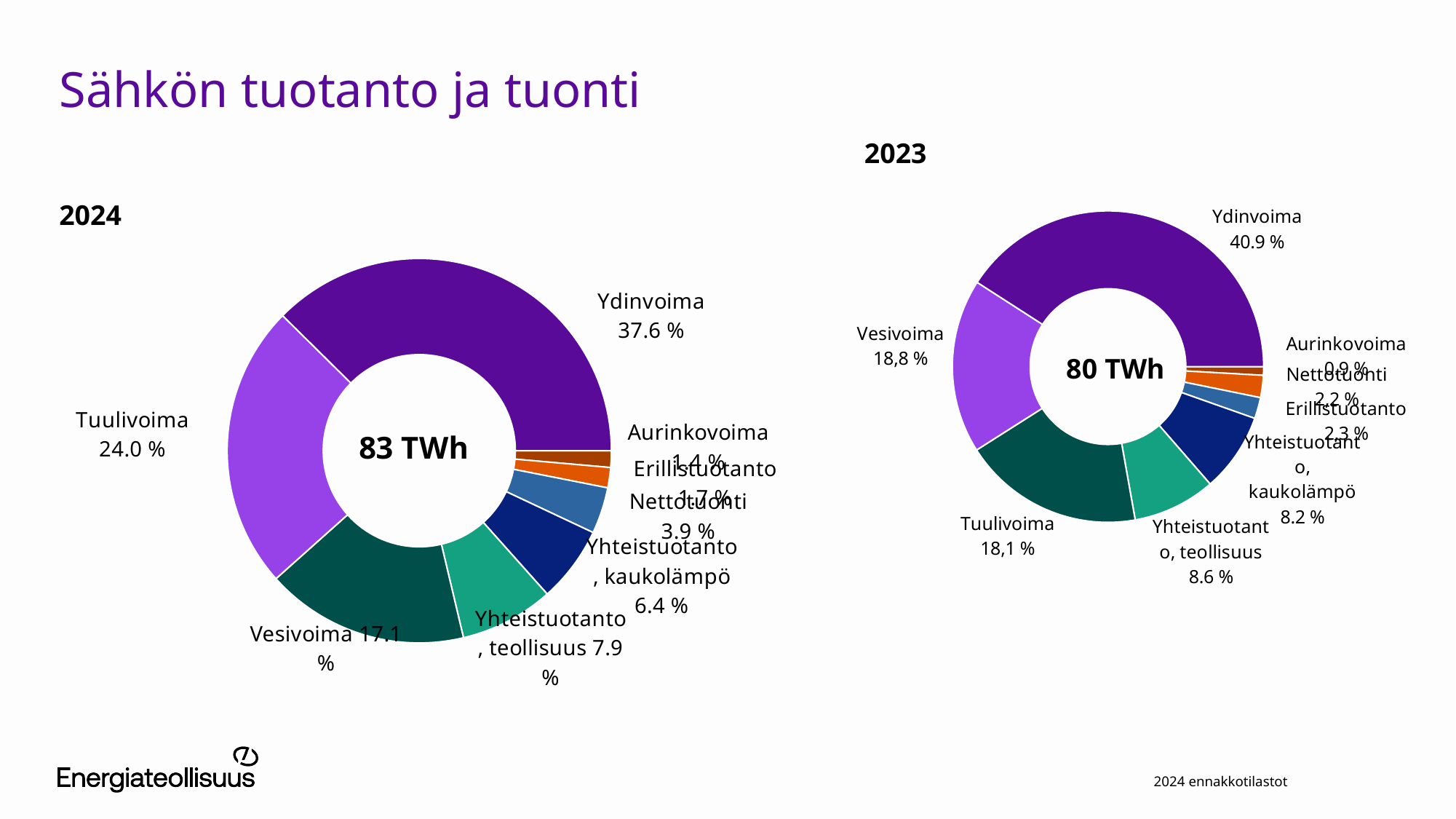
In the 2024 chart, what is the difference between the shares of Tuulivoima and Vesivoima? 6.9 % In the 2023 chart, what share does Ydinvoima have? 40.9 % In the 2024 chart, what share does Ydinvoima have? 37.6 % In the 2023 chart, what share does Vesivoima have? 18,8 % What total is shown in the centre of the 2023 chart? 80 TWh What is the title of the slide? Sähkön tuotanto ja tuonti What total is shown in the centre of the 2024 chart? 83 TWh What kind of chart is used on this slide? Donut (pie) chart In the 2024 chart, what share does Yhteistuotanto, kaukolämpö have? 6.4 % In the 2024 chart, what share does Tuulivoima have? 24.0 % In the 2023 chart, which is larger, Vesivoima or Tuulivoima? Vesivoima In the 2024 chart, which category has the largest share? Ydinvoima